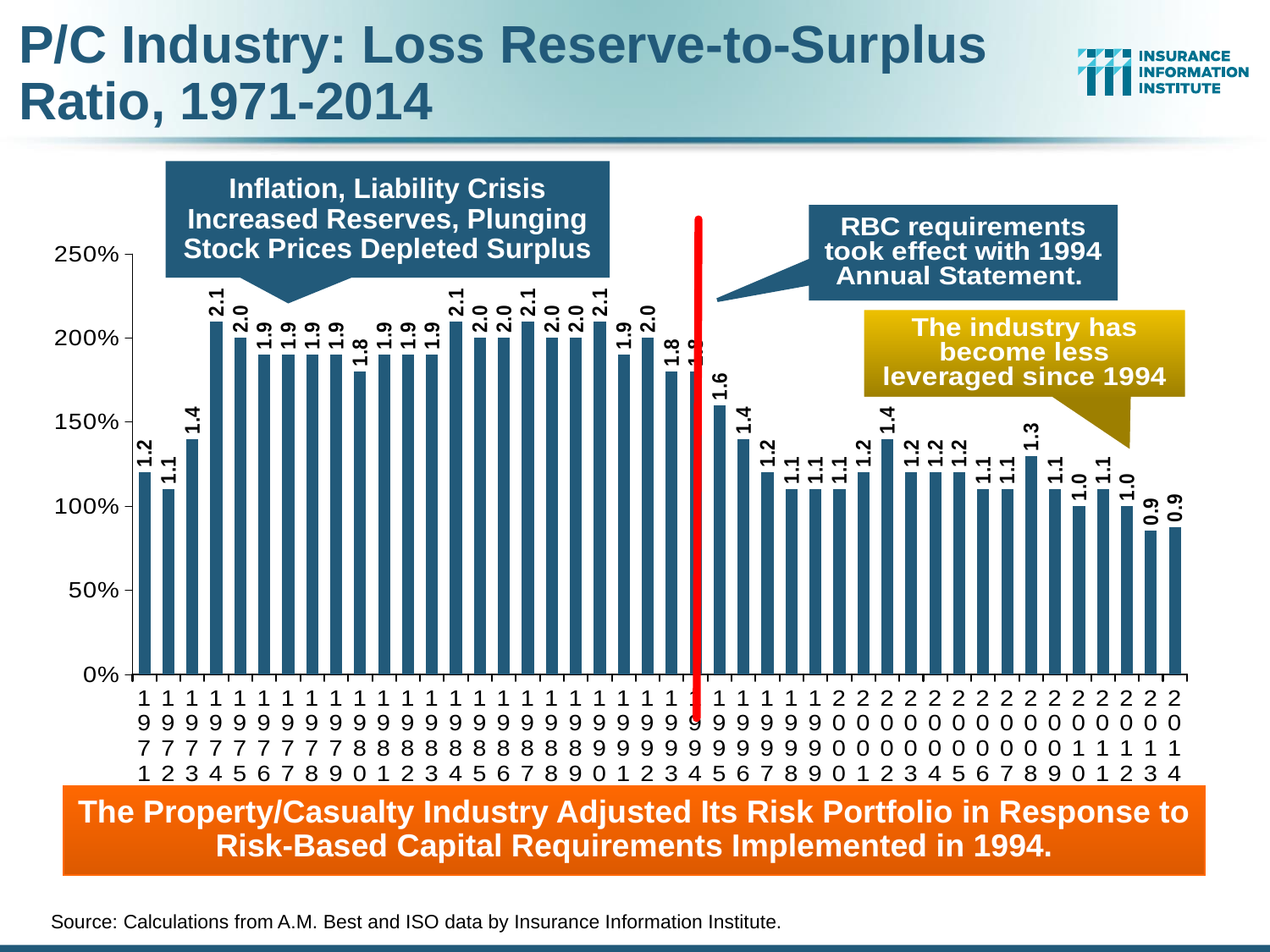
How many years are plotted on the chart? 44 Is the value for 2013 greater or less than 100%? less Which year does the red vertical line on the chart mark? 1994 What is the difference between the values for 1974 and 2014? 1.2 What is the value shown for 2008? 1.3 What is the value shown for 2014? 0.9 What kind of chart is shown on the slide? Bar chart Do the values generally rise or fall from 1995 to 2014? Fall Which year has the larger value, 1995 or 2002? 1995 What is the loss reserve-to-surplus ratio shown for 1974? 2.1 What is the value shown for 1995? 1.6 Is the value for 1990 greater or less than 200%? greater